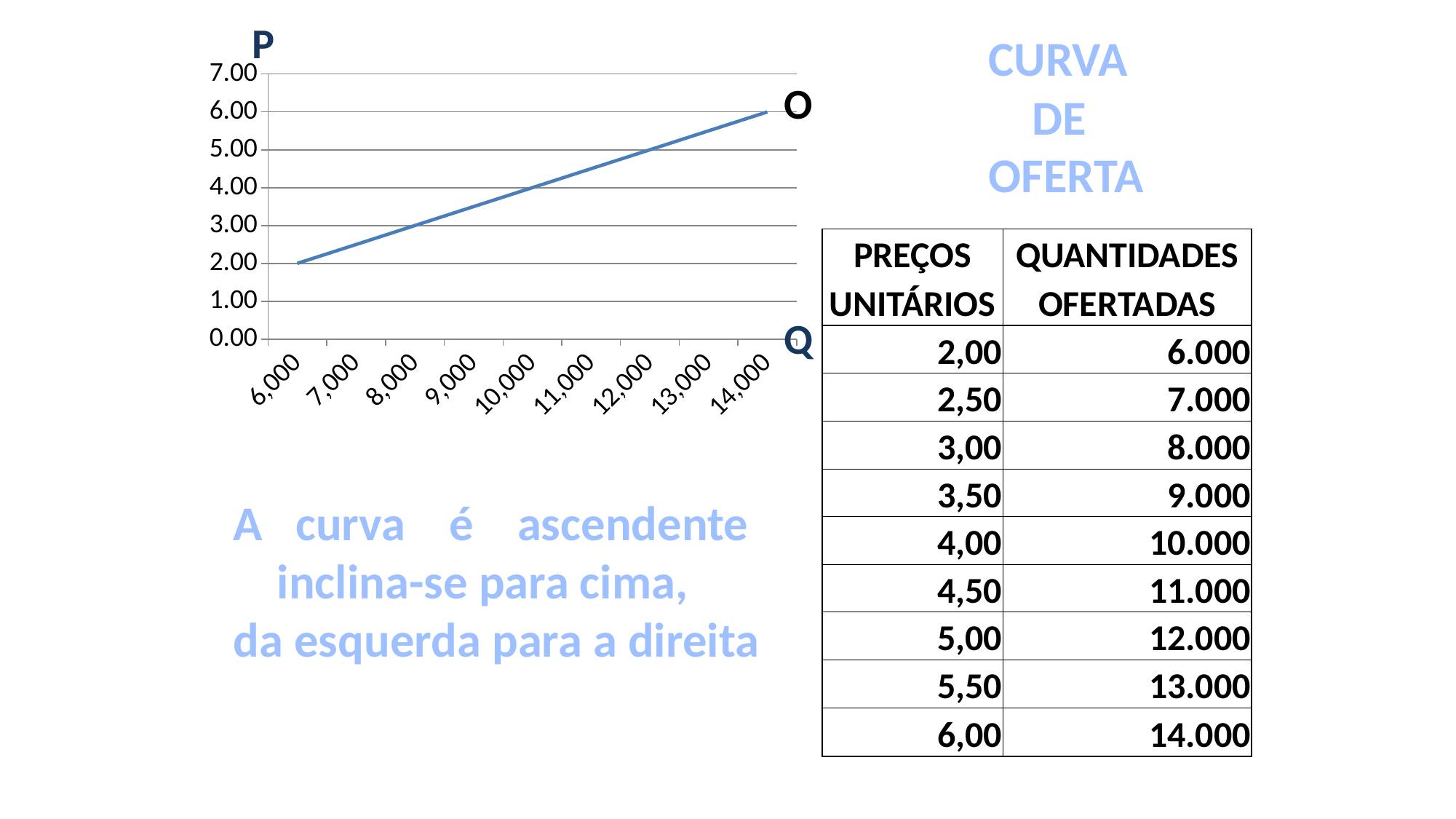
What is the value of P at Q = 10,000 on the chart? 4.00 At which Q value on the chart is P highest? 14,000 What is the value of P at Q = 14,000 on the chart? 6.00 Does the line rise or fall as Q increases from 6,000 to 14,000? rises What is the difference in P between Q = 14,000 and Q = 6,000 on the chart? 4.00 Which has a higher P value on the chart: Q = 8,000 or Q = 12,000? 12,000 What kind of chart is shown on the slide? line chart What is the title given to the curve on the slide? CURVA DE OFERTA Is the value of P at Q = 12,000 greater or less than 4.00? greater What is the value of P at Q = 6,000 on the chart? 2.00 At which Q value on the chart is P lowest? 6,000 How many tick labels are shown on the Q (horizontal) axis of the chart? 9